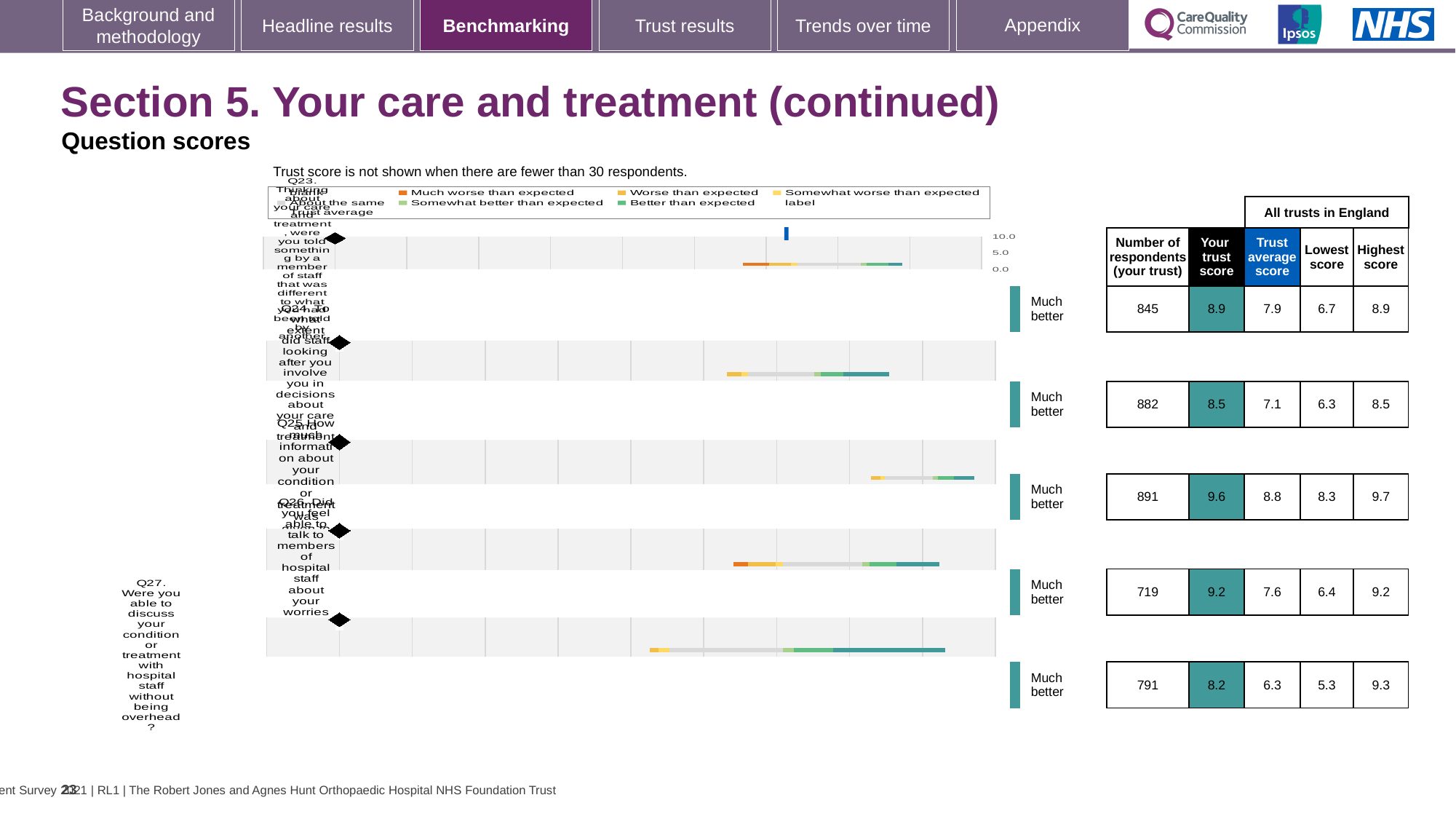
Which question has the lowest trust score for this trust? Q27 What is the highest score among all trusts in England for Q25? 9.7 What kind of chart is used to show the question scores? Bar chart What is the trust score for Q27 (Were you able to discuss your condition or treatment with hospital staff without being overheard?)? 8.2 Which question had the most respondents? Q25 How many questions are shown on the chart? 5 What is the difference between the trust score and the trust average score for Q27? 1.9 Which question has the highest trust score for this trust? Q25 According to the note above the chart, the trust score is not shown when there are fewer than how many respondents? 30 How many respondents answered Q25 (How much information about your condition or treatment was given to you?)? 891 Which has the higher trust score, Q23 or Q24? Q23 What is the trust average score for Q24 (Did staff looking after you involve you in decisions about your care and treatment?)? 7.1